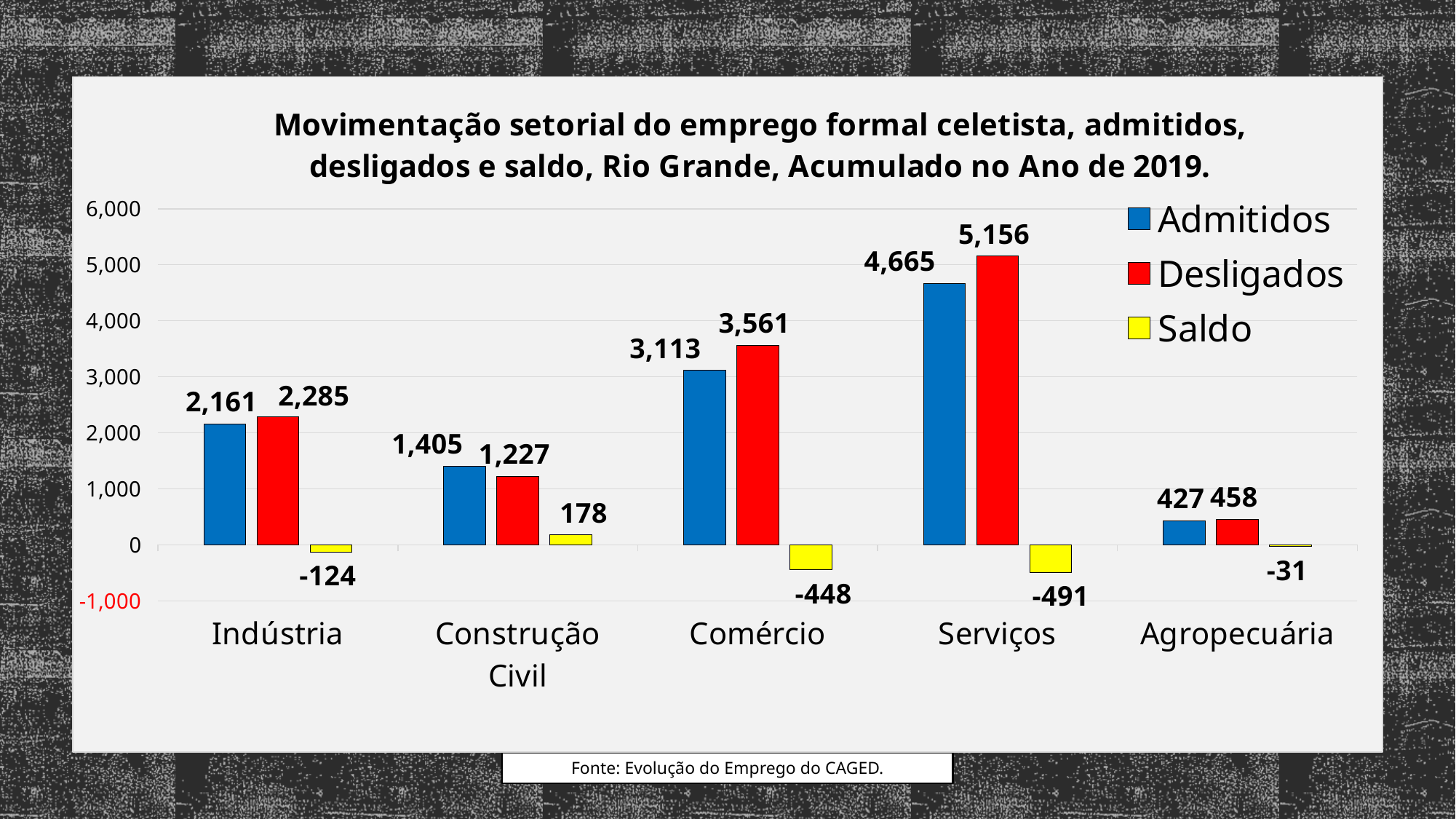
How many series does the legend list? 3 Which is larger for Construção Civil, Admitidos or Desligados? Admitidos What is the Saldo value for Agropecuária? -31 What is the Saldo value for Construção Civil? 178 Which sector has the highest Admitidos value? Serviços How many sectors are shown on the x axis? 5 What is the Desligados value for Serviços? 5,156 Which sector has the lowest Desligados value? Agropecuária What is the difference between Desligados and Admitidos for Indústria? 124 What kind of chart is shown on the slide? Bar chart What is the Admitidos value for Comércio? 3,113 Which colour represents the Saldo series? Yellow